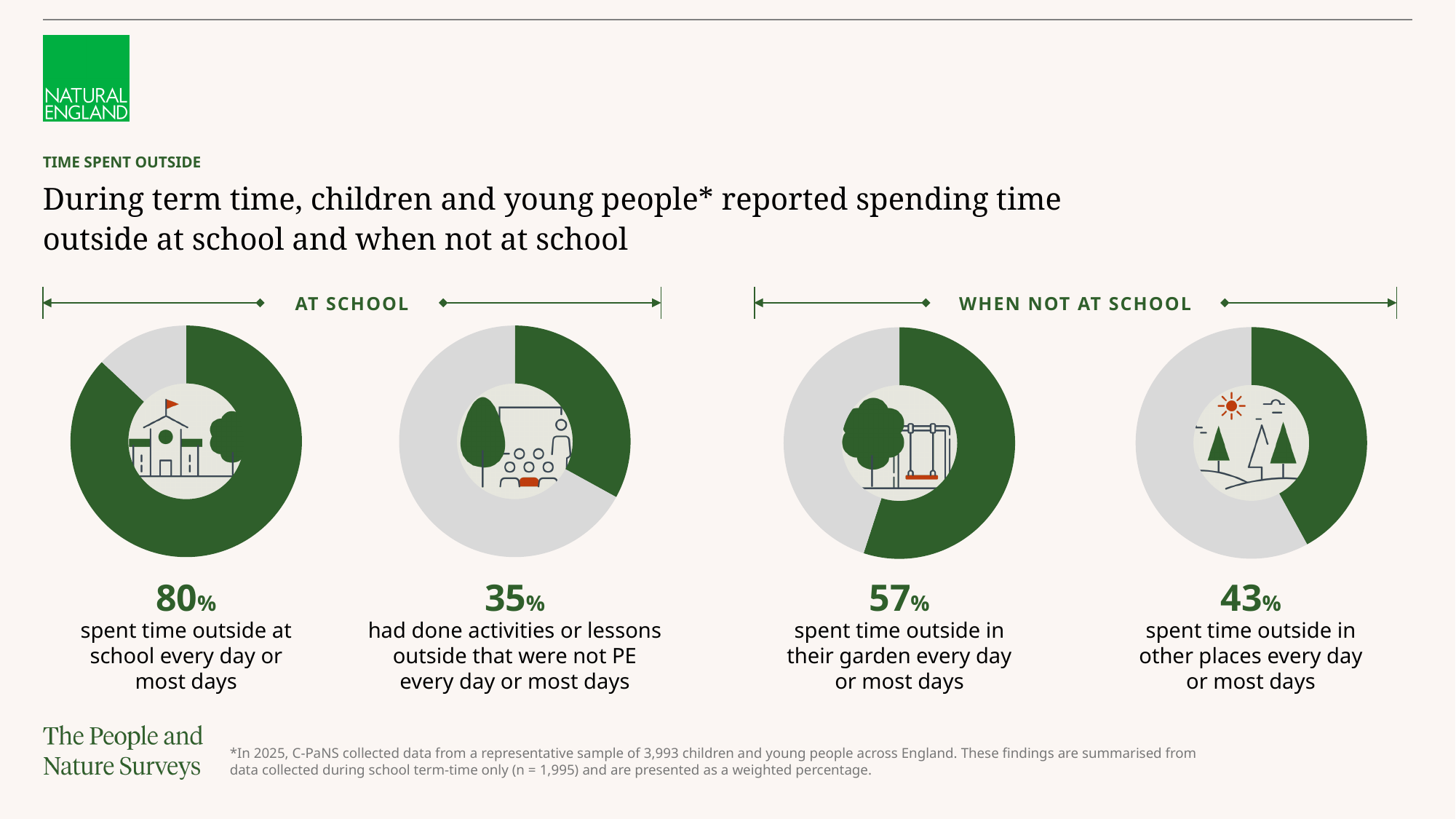
Which of the four donut charts shows the lowest percentage? Had done activities or lessons outside that were not PE every day or most days (35%) Which is larger: the percentage who spent time outside in their garden every day or most days, or the percentage who spent time outside in other places every day or most days? Spent time outside in their garden (57%) Which of the four donut charts shows the highest percentage? Spent time outside at school every day or most days (80%) In the second donut chart under 'At school', what percentage had done activities or lessons outside that were not PE every day or most days? 35% How many donut charts are grouped under the 'When not at school' heading? 2 What type of chart is used to display the percentages on this slide? Donut (pie) chart What is the difference between the percentage who spent time outside at school every day or most days and the percentage who had done non-PE activities or lessons outside every day or most days? 45% In the first donut chart under 'When not at school', what percentage spent time outside in their garden every day or most days? 57% In the rightmost donut chart, what percentage spent time outside in other places every day or most days? 43% What percentage of children and young people spent time outside at school every day or most days, according to the first donut chart? 80% What is the difference between the percentage who spent time outside in their garden and the percentage who spent time outside in other places every day or most days? 14% How many donut charts are shown on the slide? 4